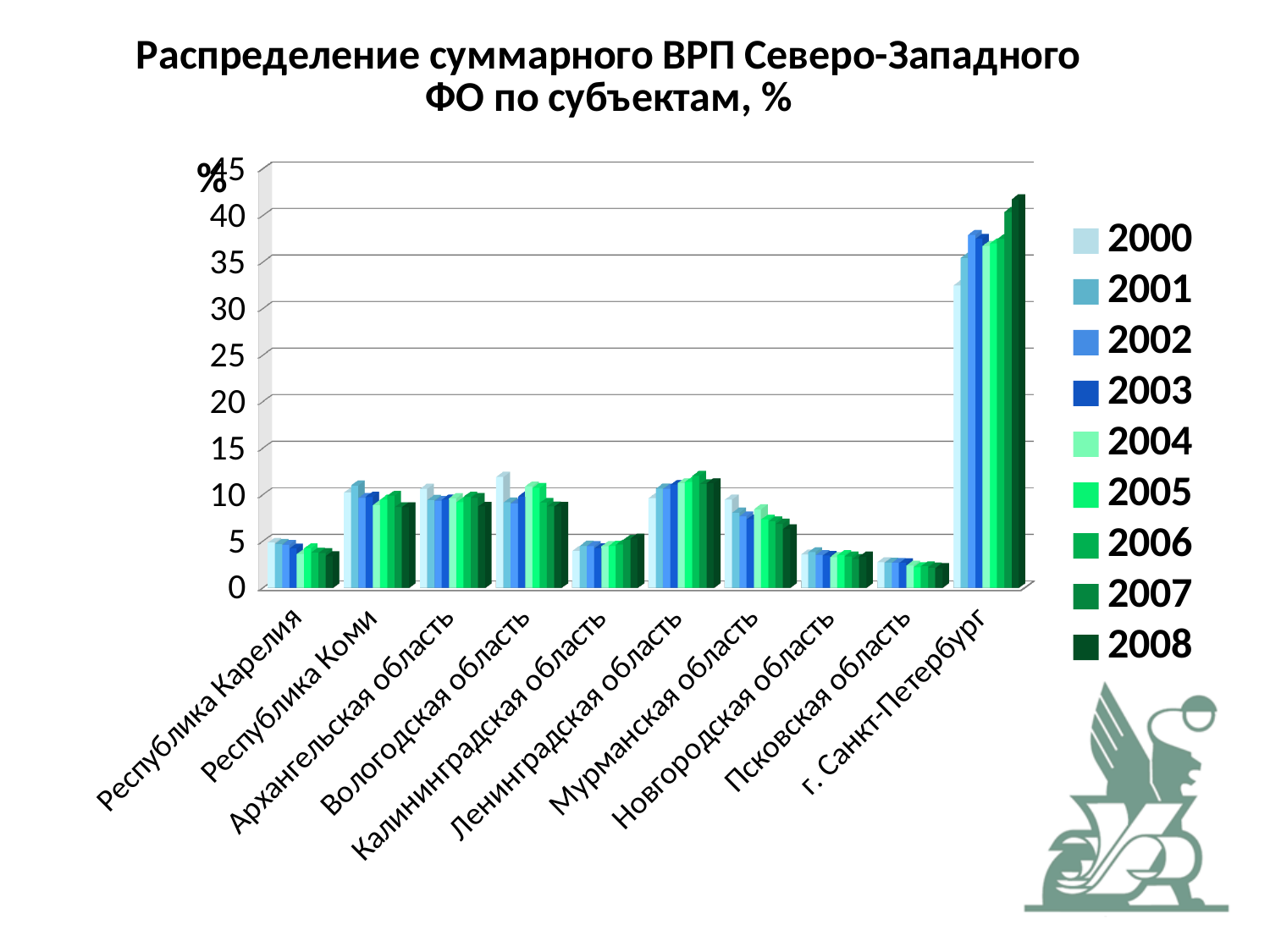
Which region has the highest share of the total GRP in every year? г. Санкт-Петербург Is the value for г. Санкт-Петербург in 2008 greater or less than 35? greater Do the values for г. Санкт-Петербург rise or fall from 2000 to 2008? rise What kind of chart is shown on the slide? bar chart Is the value for Псковская область in 2000 greater or less than 5? less Which region has the lowest share of the total GRP in 2008? Псковская область How many series (years) does the legend list? 9 Which is larger in 2000: the value for Республика Коми or the value for Республика Карелия? Республика Коми Do the values for Мурманская область rise or fall from 2000 to 2008? fall Is the value for Республика Карелия in 2000 greater or less than 10? less Which is larger in 2008: the value for г. Санкт-Петербург or the value for Республика Коми? г. Санкт-Петербург How many regions (categories) are shown on the x axis? 10